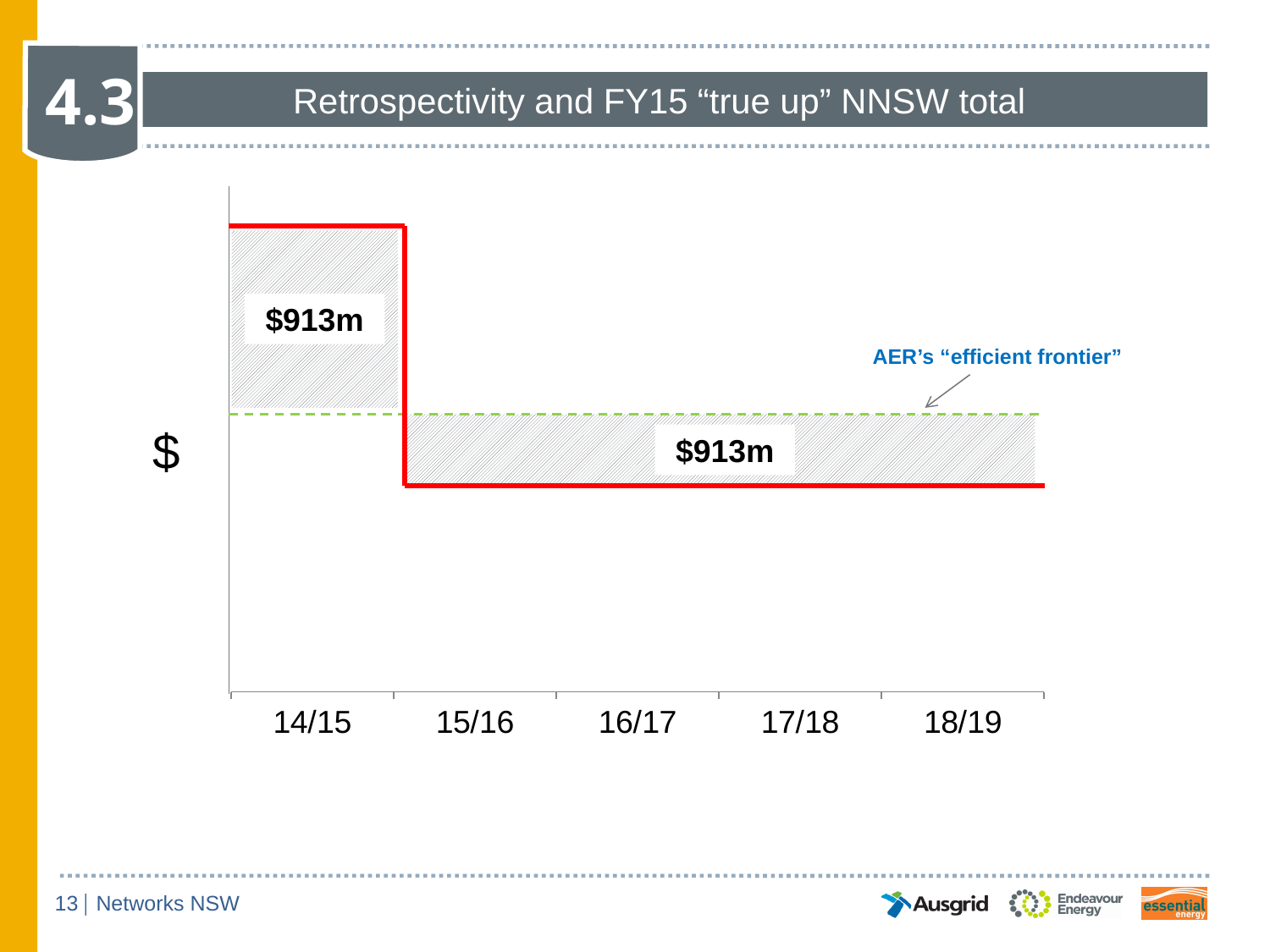
Which year on the x axis has the highest level of the red line? 14/15 What amount is labelled in the shaded area above the dashed line for 14/15? $913m How many years are labelled on the x axis? 5 What does the green dashed horizontal line represent? AER's "efficient frontier" What is the label on the y axis of the chart? $ Is the red line higher in 14/15 or in 15/16? 14/15 Does the red line rise, fall or stay flat from 15/16 to 18/19? stay flat Does the red line rise or fall from 14/15 to 15/16? fall Is the red line higher in 14/15 or in 17/18? 14/15 What amount is labelled in the shaded area below the dashed line spanning 15/16 to 18/19? $913m What kind of chart is shown on the slide? line chart